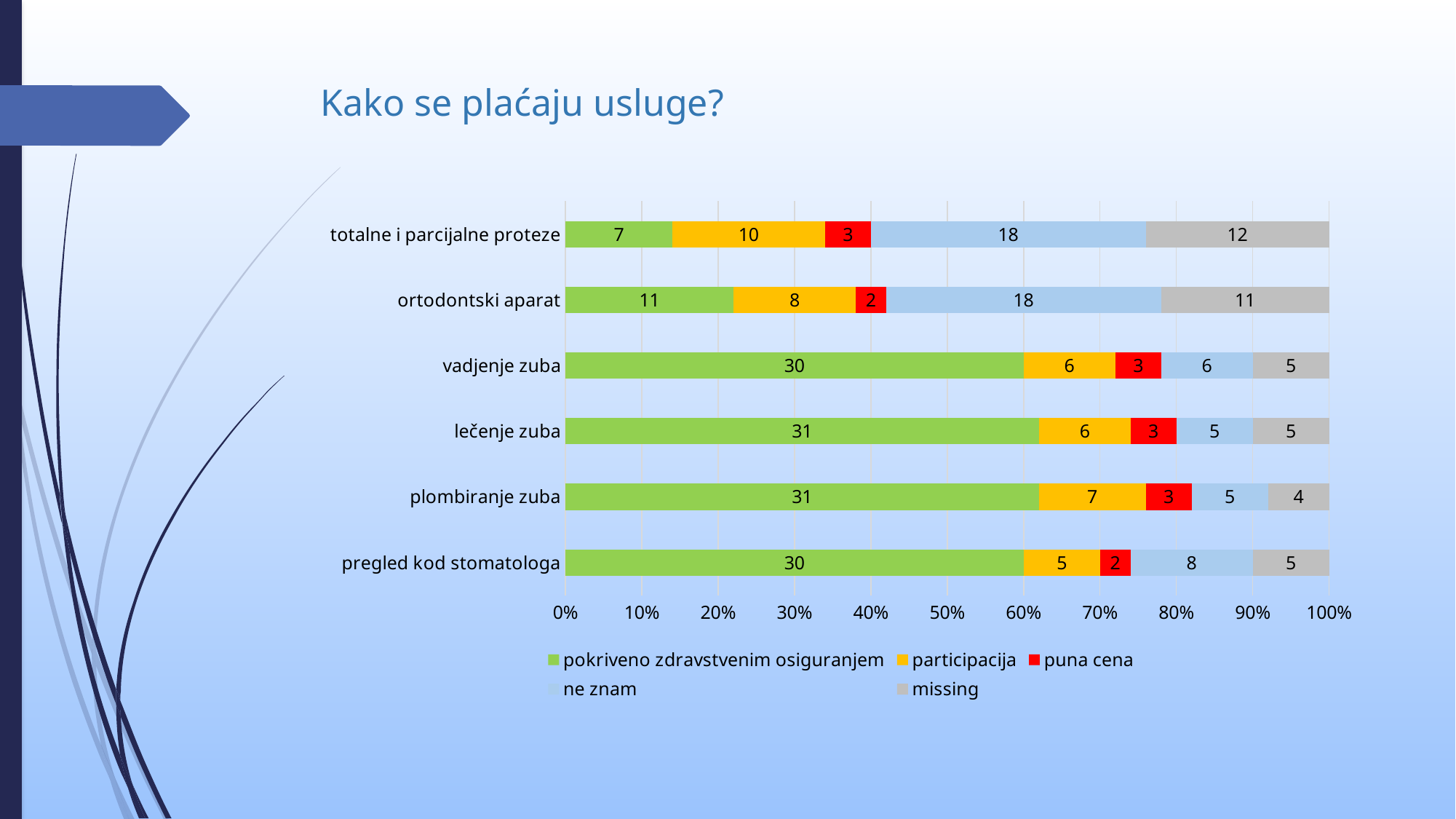
How many categories are shown on the y axis? 6 What is the value of 'participacija' for 'pregled kod stomatologa'? 5 What is the value of 'ne znam' for 'totalne i parcijalne proteze'? 18 What is the difference between the 'pokriveno zdravstvenim osiguranjem' values for 'lečenje zuba' and 'ortodontski aparat'? 20 Which is larger: the 'participacija' value for 'totalne i parcijalne proteze' or for 'plombiranje zuba'? totalne i parcijalne proteze How many series does the legend list? 5 Which category has the highest value for 'missing'? totalne i parcijalne proteze What is the value of 'pokriveno zdravstvenim osiguranjem' for 'vadjenje zuba'? 30 What is the total of all segments in the bar for 'pregled kod stomatologa'? 50 Which category has the lowest value for 'pokriveno zdravstvenim osiguranjem'? totalne i parcijalne proteze What kind of chart is shown on the slide? stacked bar chart What is the value of 'missing' for 'ortodontski aparat'? 11